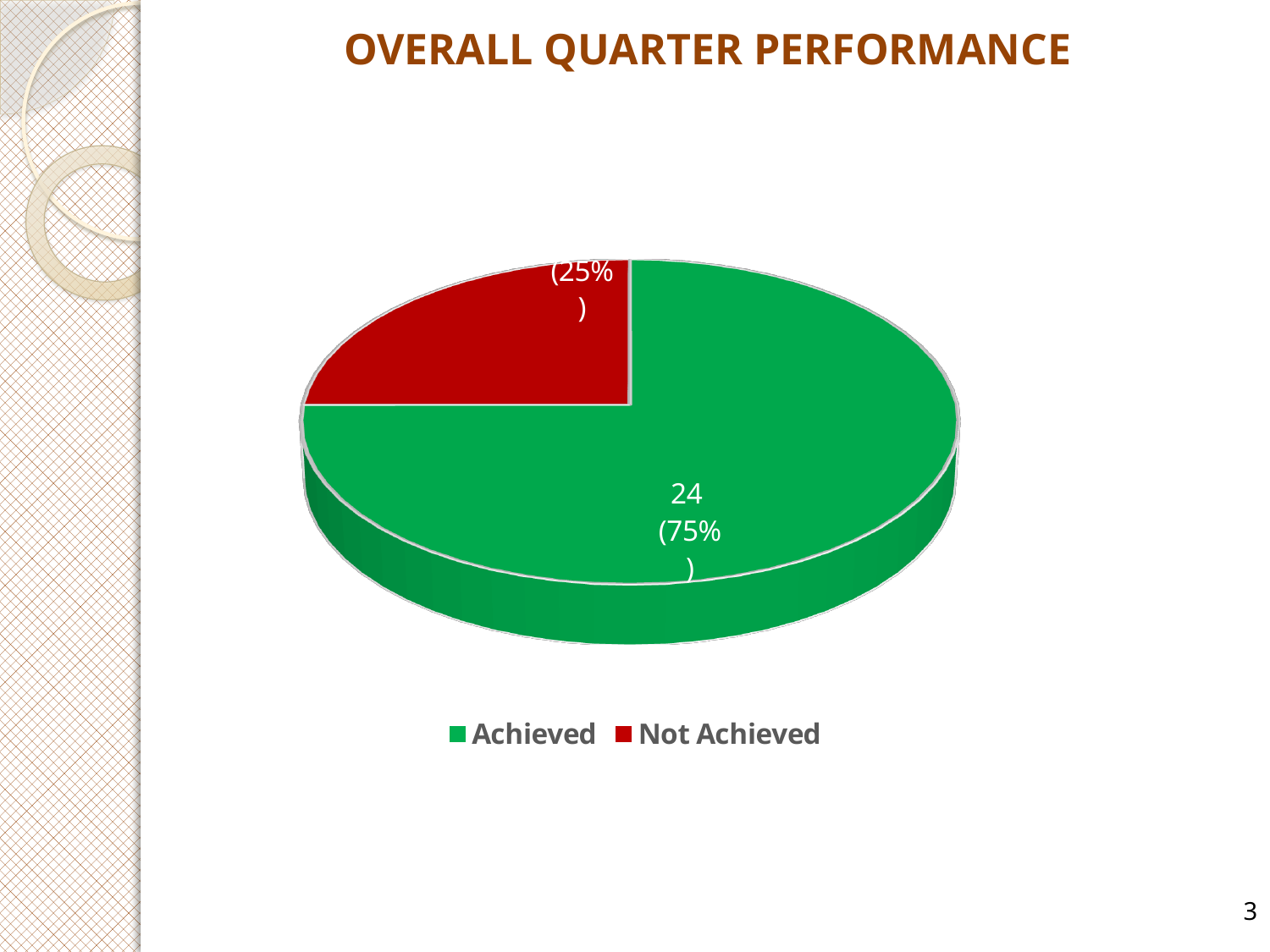
What share of the pie does the Achieved slice represent? 75% What is the value shown for the Achieved slice? 24 How many slices does the pie chart have? 2 What is the difference in percentage points between the Achieved share and the Not Achieved share? 50% Which slice is the largest in the pie chart? Achieved What kind of chart is shown on the slide? pie chart What is the title of the chart? OVERALL QUARTER PERFORMANCE How many series does the legend list? 2 Which slice is the smallest in the pie chart? Not Achieved What colour is used for the Not Achieved slice? red Which is larger, the Achieved slice or the Not Achieved slice? Achieved What share of the pie does the Not Achieved slice represent? 25%